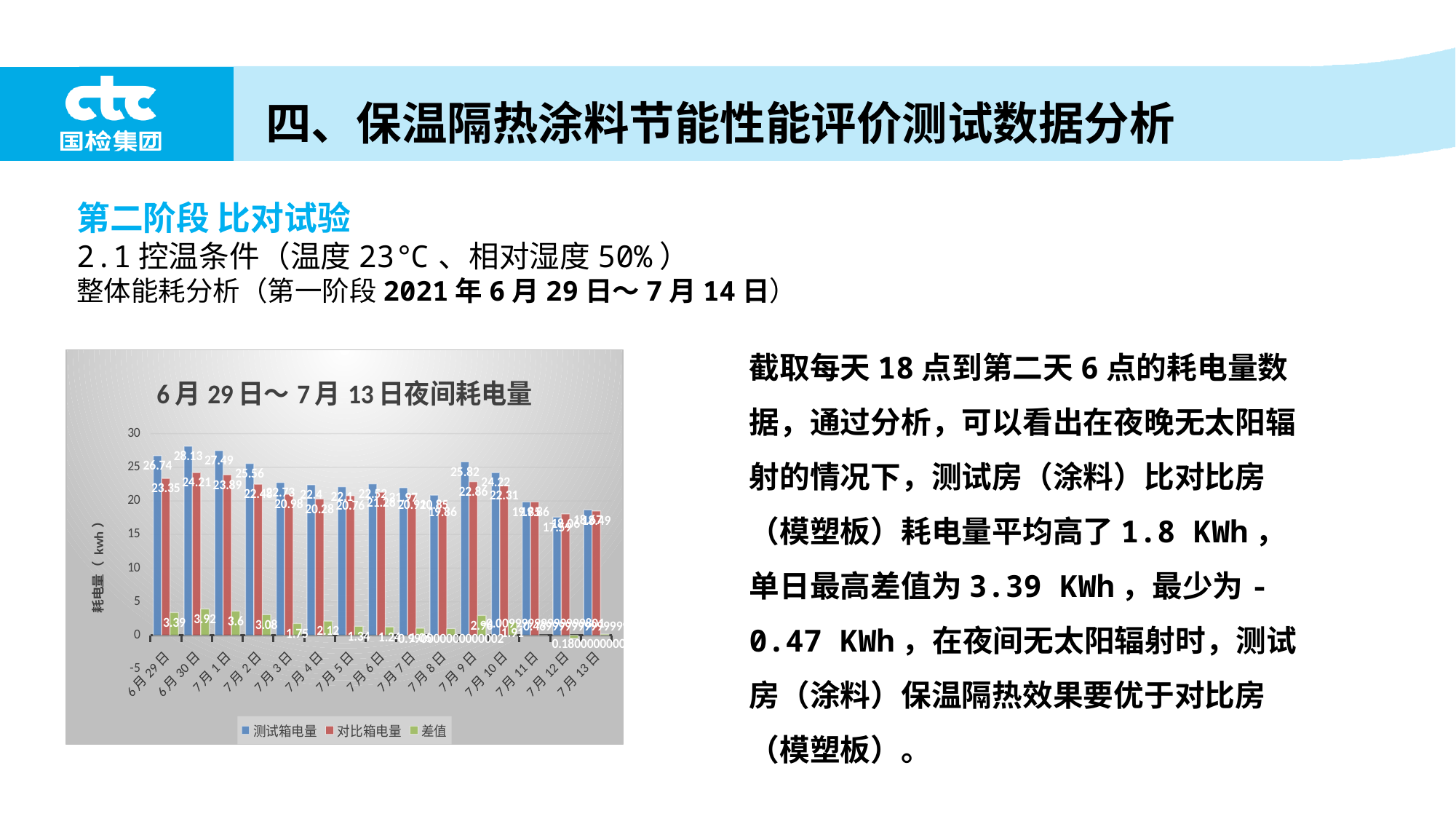
What is the 测试箱电量 value for 6月29日? 26.74 On 6月30日, which is larger: 测试箱电量 or 对比箱电量? 测试箱电量 What kind of chart is shown on the slide? bar chart What is the title of the chart? 6月29日～7月13日夜间耗电量 Is the 测试箱电量 value for 7月9日 greater or less than 25? greater What is the 对比箱电量 value for 7月1日? 23.89 How many series does the legend list? 3 How many dates are shown on the x axis? 15 What is the difference between 测试箱电量 and 对比箱电量 on 6月29日? 3.39 On which date is 测试箱电量 highest? 6月30日 What is the label on the vertical axis? 耗电量（kwh） What is the 差值 value for 6月30日? 3.92